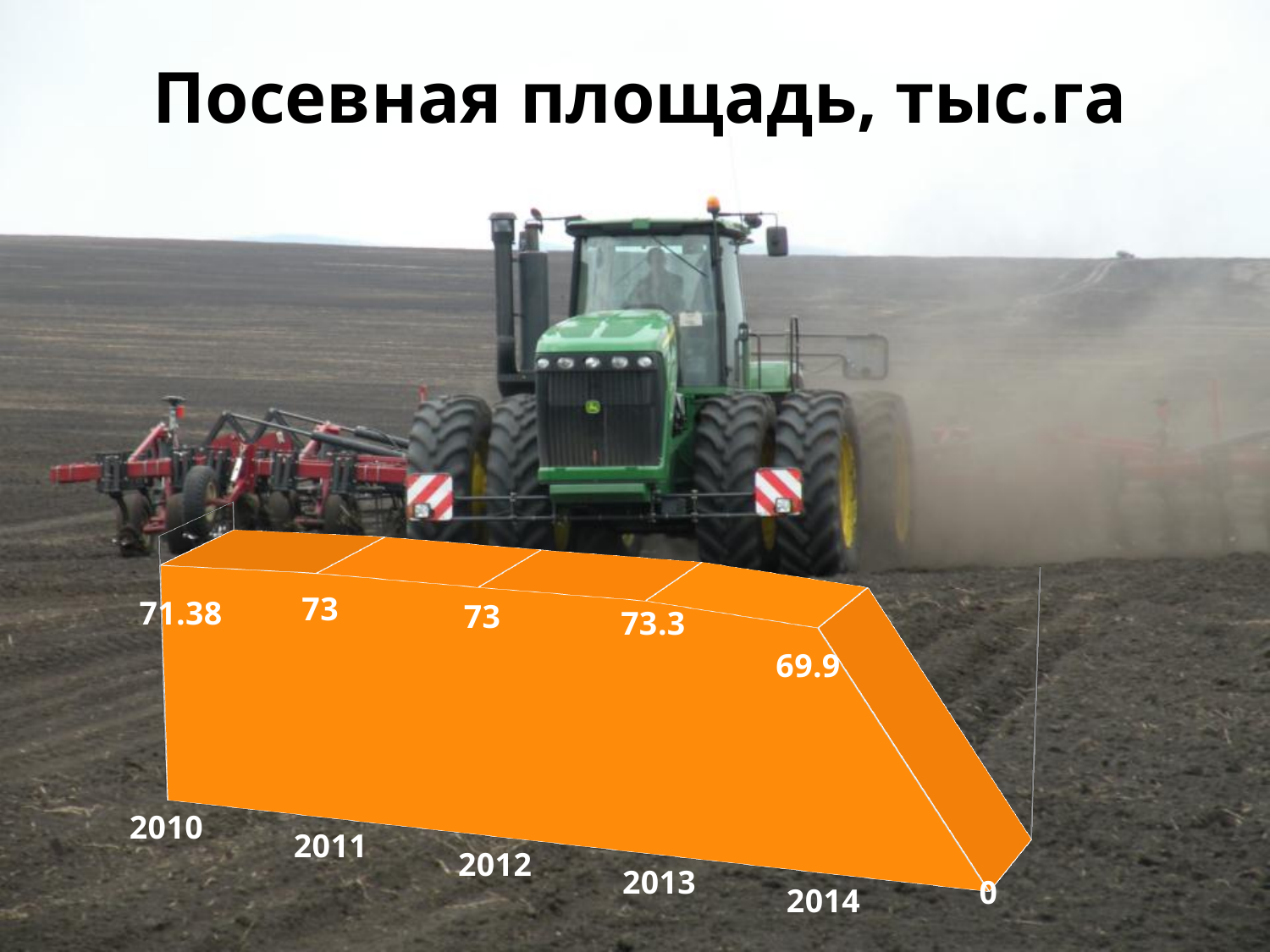
What is the value for 2010? 71.38 What is the title of the chart? Посевная площадь, тыс.га How many years are labeled on the x axis? 5 Which is larger, the value for 2010 or the value for 2014? 2010 What is the difference between the values for 2011 and 2010? 1.62 Does the value rise or fall from 2013 to 2014? fall What is the value for 2014? 69.9 What type of chart is shown on the slide? area chart What is the difference between the values for 2013 and 2014? 3.4 Among the labeled years, which has the lowest value? 2014 Which labeled year has the highest value? 2013 What is the value for 2013? 73.3